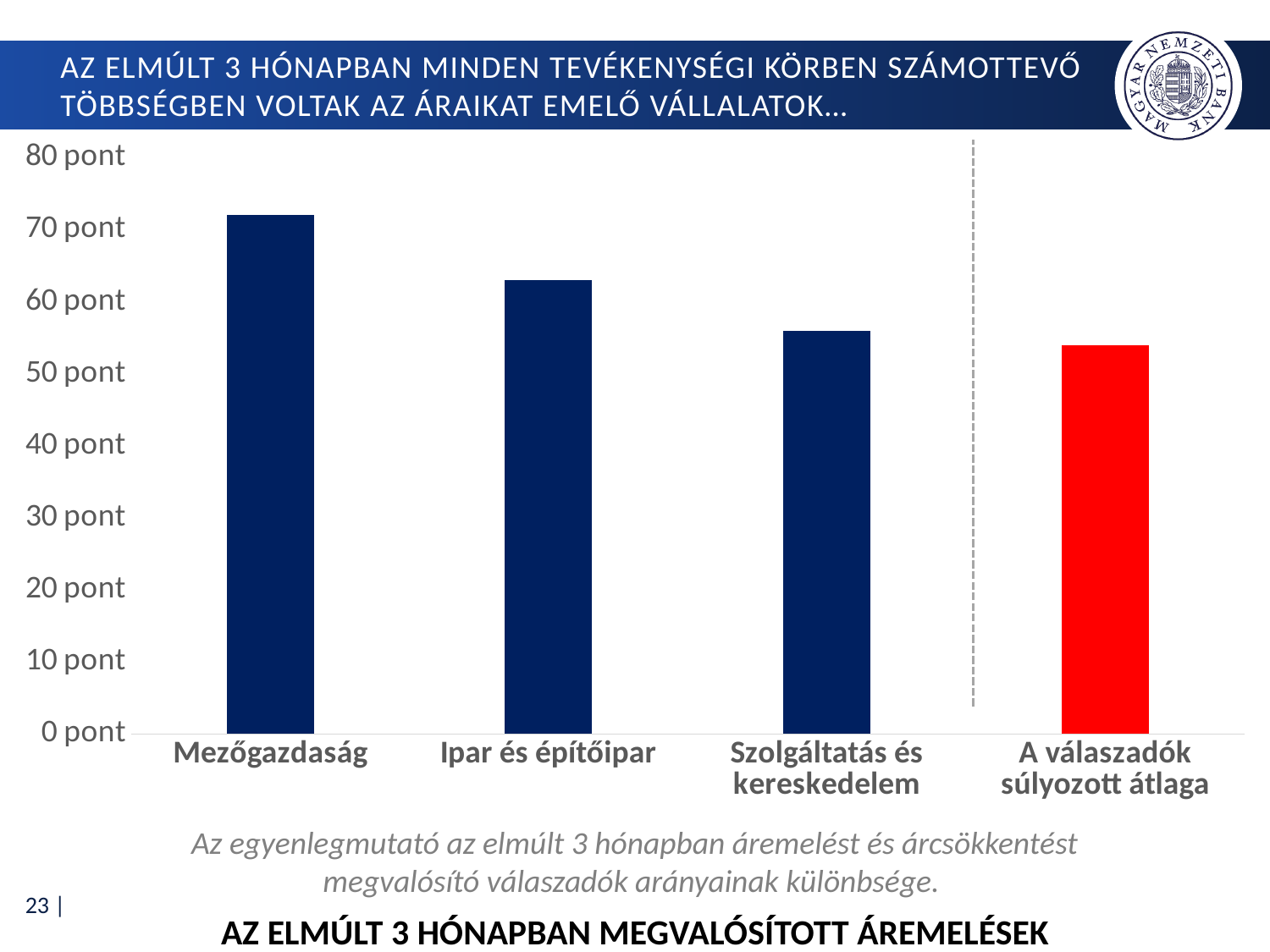
Is the value for Szolgáltatás és kereskedelem greater or less than 60 pont? less Which is larger, the value for Ipar és építőipar or the value for Szolgáltatás és kereskedelem? Ipar és építőipar Which bar in the chart is coloured red? A válaszadók súlyozott átlaga Is the value for Mezőgazdaság greater or less than 70 pont? greater Is the value for A válaszadók súlyozott átlaga greater or less than 50 pont? greater Do the values for the three sector categories (Mezőgazdaság, Ipar és építőipar, Szolgáltatás és kereskedelem) rise or fall from left to right? fall Which is larger, the value for Mezőgazdaság or the value for Ipar és építőipar? Mezőgazdaság How many categories are shown on the x axis of the chart? 4 What is the title printed below the chart? AZ ELMÚLT 3 HÓNAPBAN MEGVALÓSÍTOTT ÁREMELÉSEK Which category has the highest value in the chart? Mezőgazdaság What kind of chart is shown on the slide? bar chart